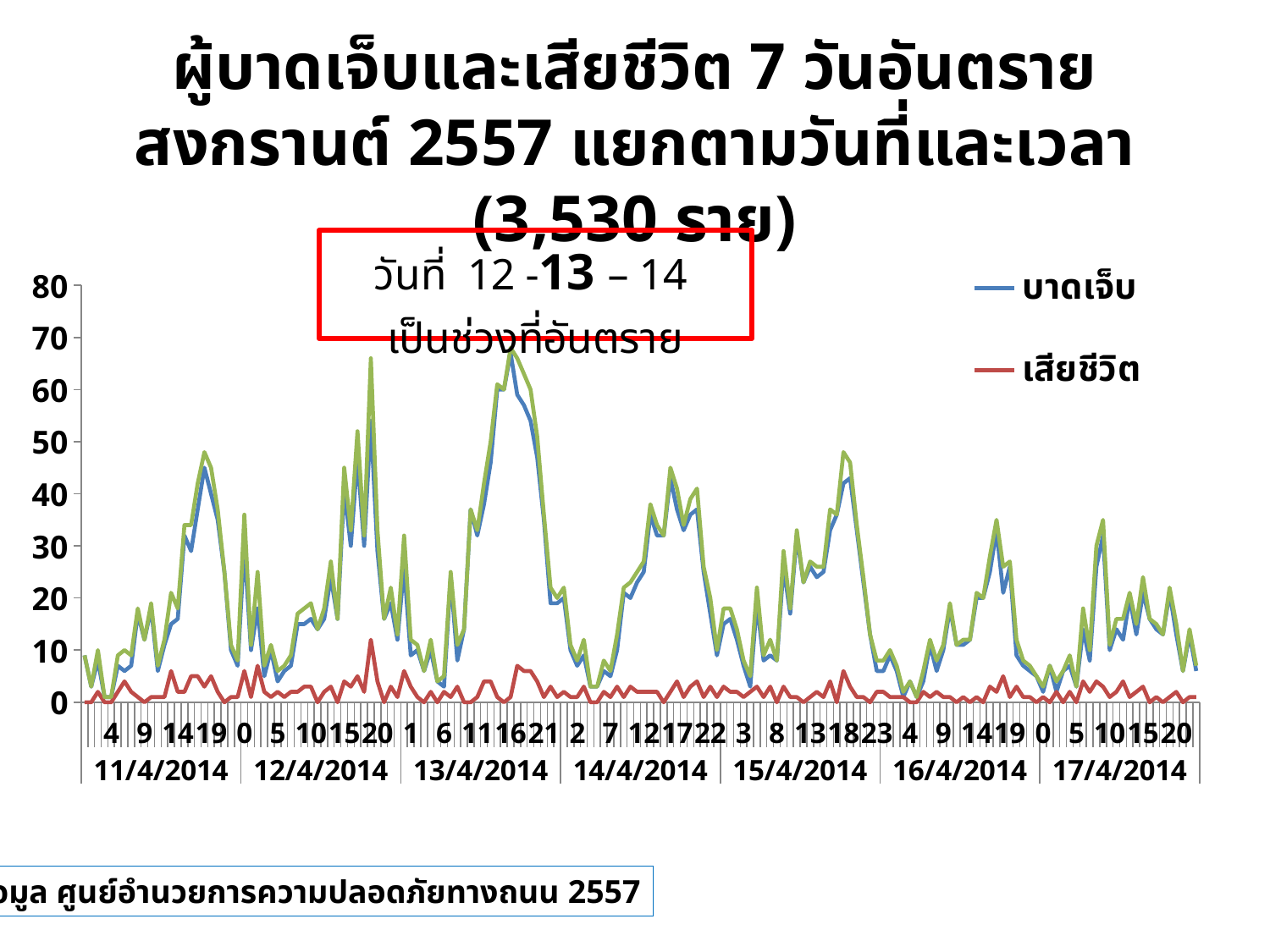
On which date does the บาดเจ็บ line reach its highest peak? 13/4/2014 Which series has higher values throughout the chart, บาดเจ็บ or เสียชีวิต? บาดเจ็บ Is the highest value of the เสียชีวิต line greater or less than 20? less Is the highest value of the บาดเจ็บ line greater or less than 50? greater What kind of chart is shown on the slide? line chart How many series does the legend list? 2 Which series is shown in red in the legend? เสียชีวิต What is the highest tick value shown on the y axis? 80 Is the peak of the บาดเจ็บ line on 15/4/2014 greater or less than 30? greater What is the total number of cases stated in the chart title? 3,530 ราย How many dates are shown along the x axis? 7